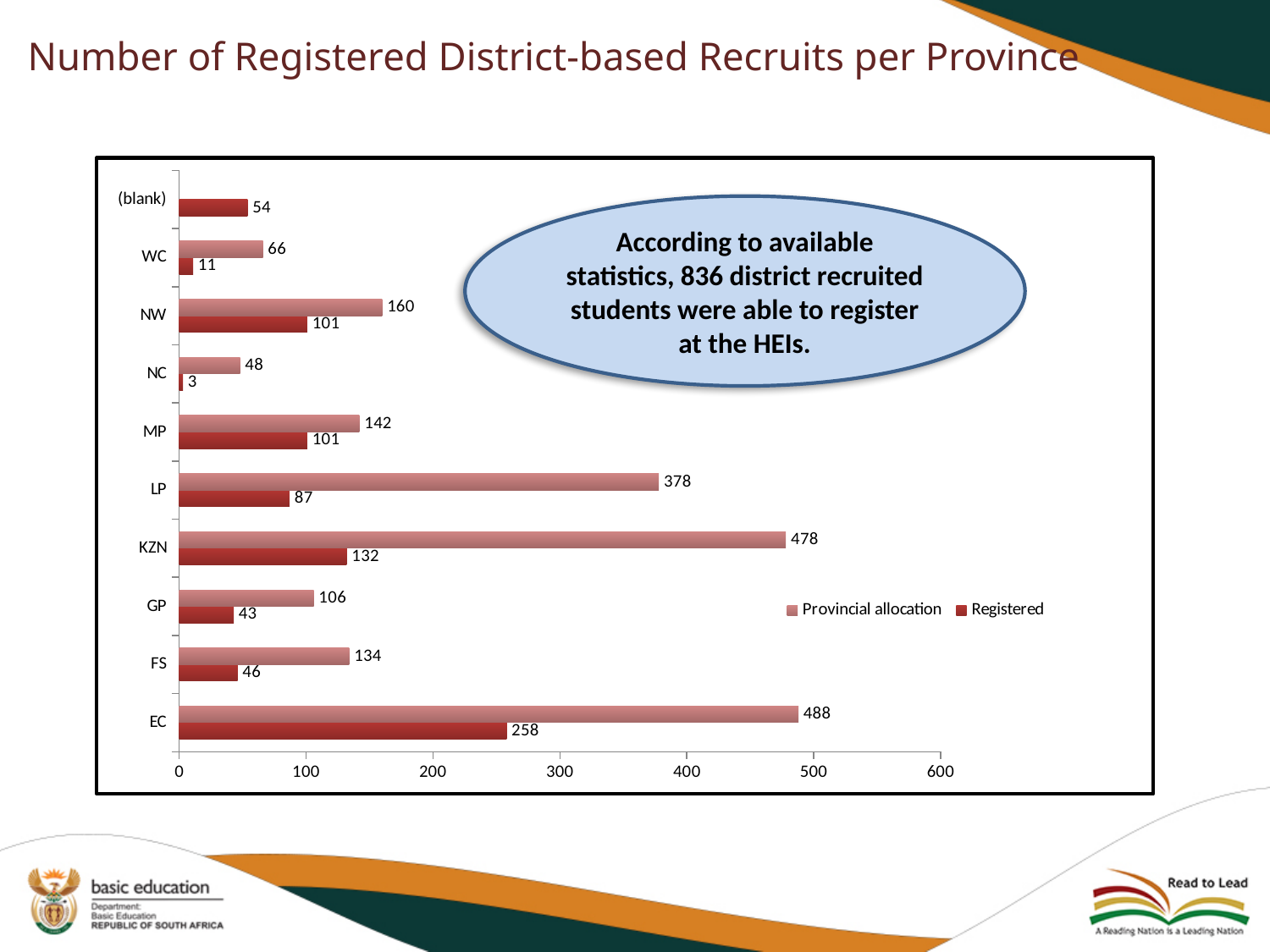
What is the difference between the Provincial allocation and Registered values for LP? 291 What is the Registered value for EC? 258 What is the Provincial allocation value for FS? 134 Which is larger, the Registered value for KZN or the Registered value for NW? KZN How many series does the legend list? 2 What kind of chart is shown on the slide? Bar chart What is the Registered value for NC? 3 How many categories are shown on the vertical axis? 10 Which province has the highest Provincial allocation? EC What is the Provincial allocation value for KZN? 478 What is the title of the slide's chart? Number of Registered District-based Recruits per Province Which province has the lowest Registered value? NC